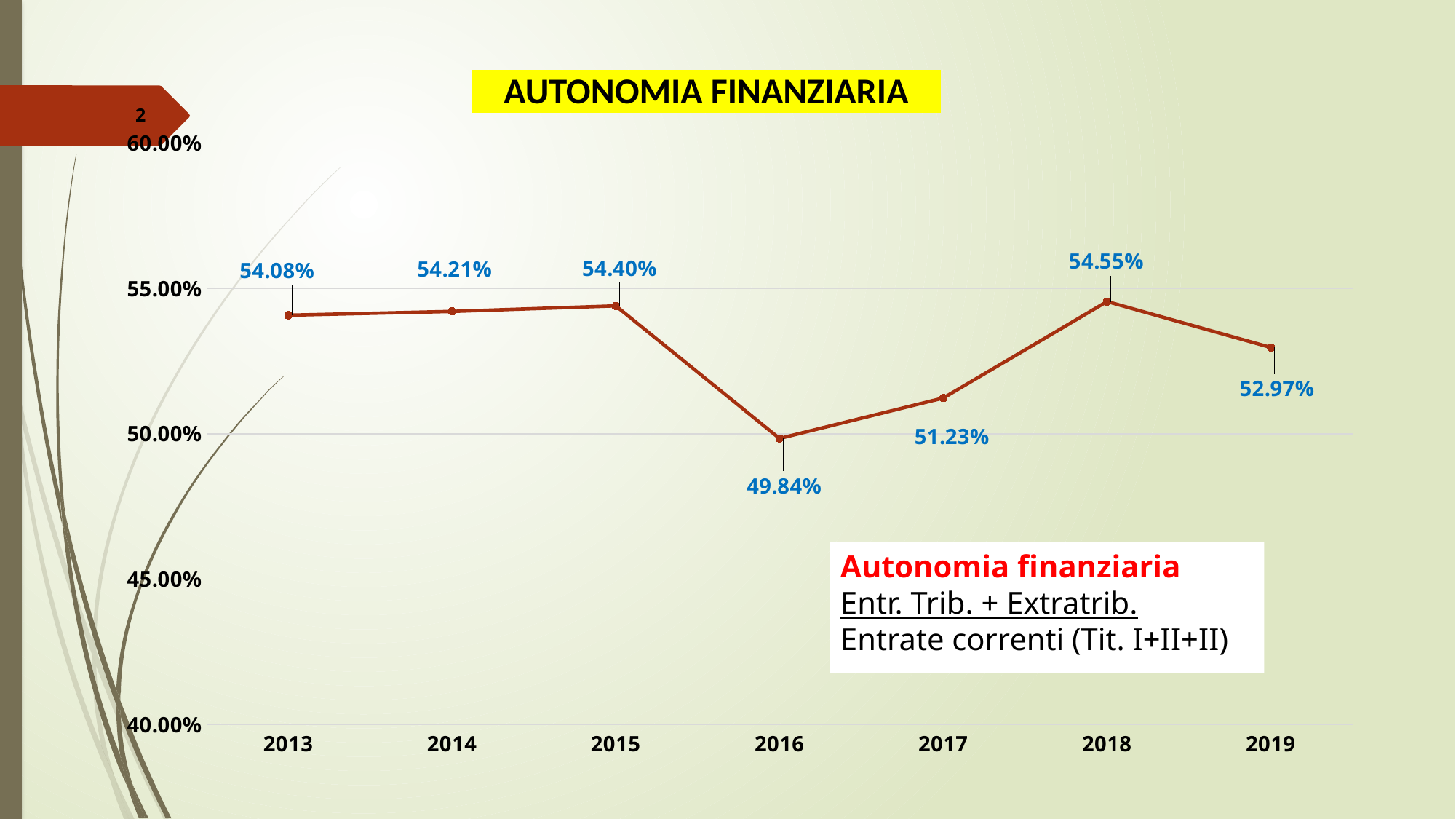
Do the values rise or fall from 2015 to 2016? fall What kind of chart is shown? line chart What is the value for 2019? 52.97% What is the title of the chart? AUTONOMIA FINANZIARIA How many years are plotted on the chart? 7 Which year has the highest value? 2018 Which is larger, the value for 2017 or the value for 2019? 2019 What is the value for 2013? 54.08% Is the value for 2016 greater or less than 50.00%? less What is the value for 2016? 49.84% Which year has the lowest value? 2016 What is the difference between the values for 2018 and 2016? 4.71%